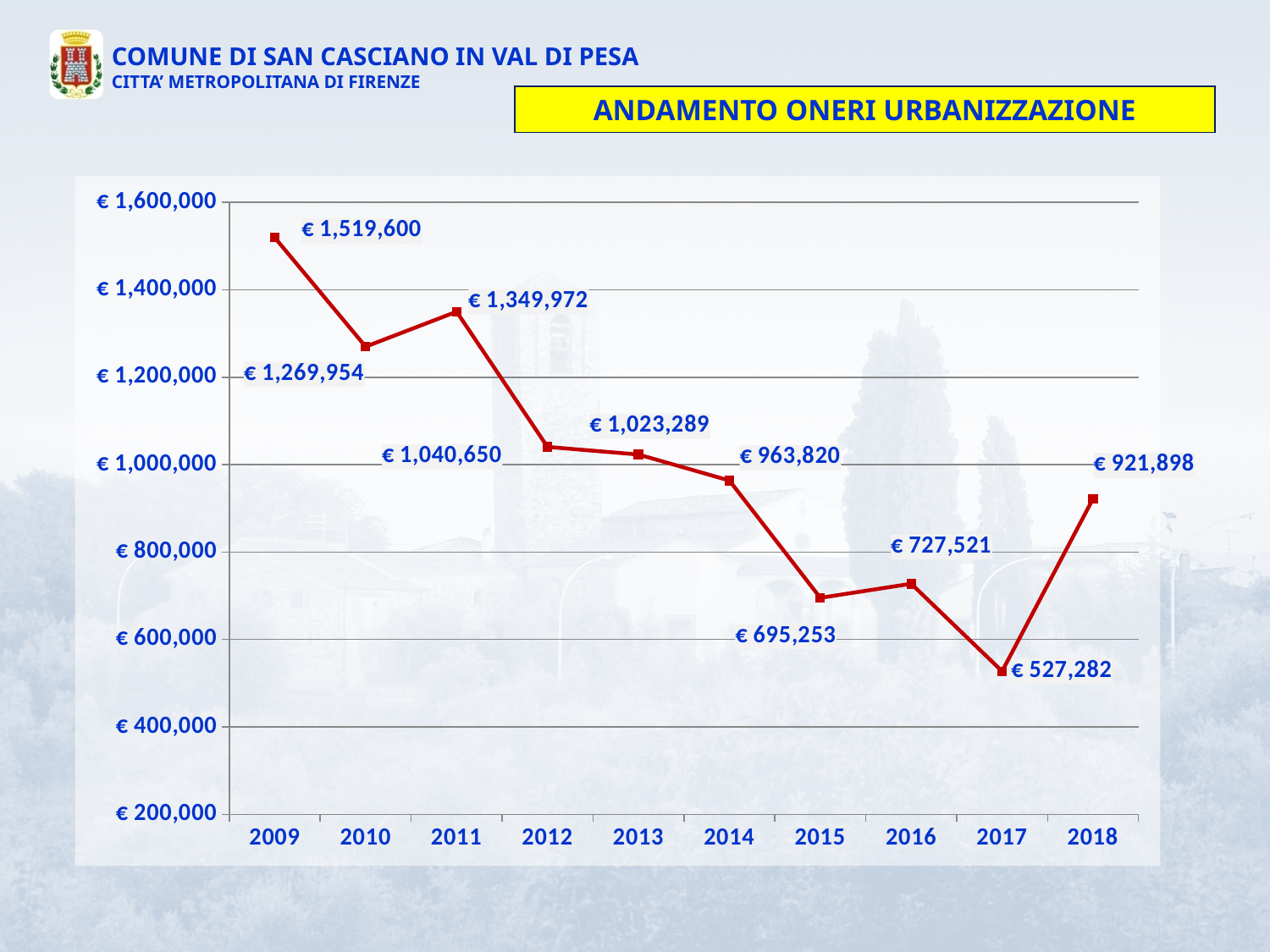
Which year has the lowest value? 2017 What is the value for 2018? € 921,898 What is the value for 2009? € 1,519,600 What is the difference between the values for 2009 and 2010? € 249,646 What is the difference between the values for 2018 and 2017? € 394,616 What is the title of the chart? ANDAMENTO ONERI URBANIZZAZIONE What type of chart is shown on the slide? Line chart Is the value for 2014 greater or less than € 1,000,000? less Which is larger, the value for 2015 or the value for 2016? 2016 How many years are plotted on the x axis? 10 Which year has the highest value? 2009 What is the value for 2013? € 1,023,289